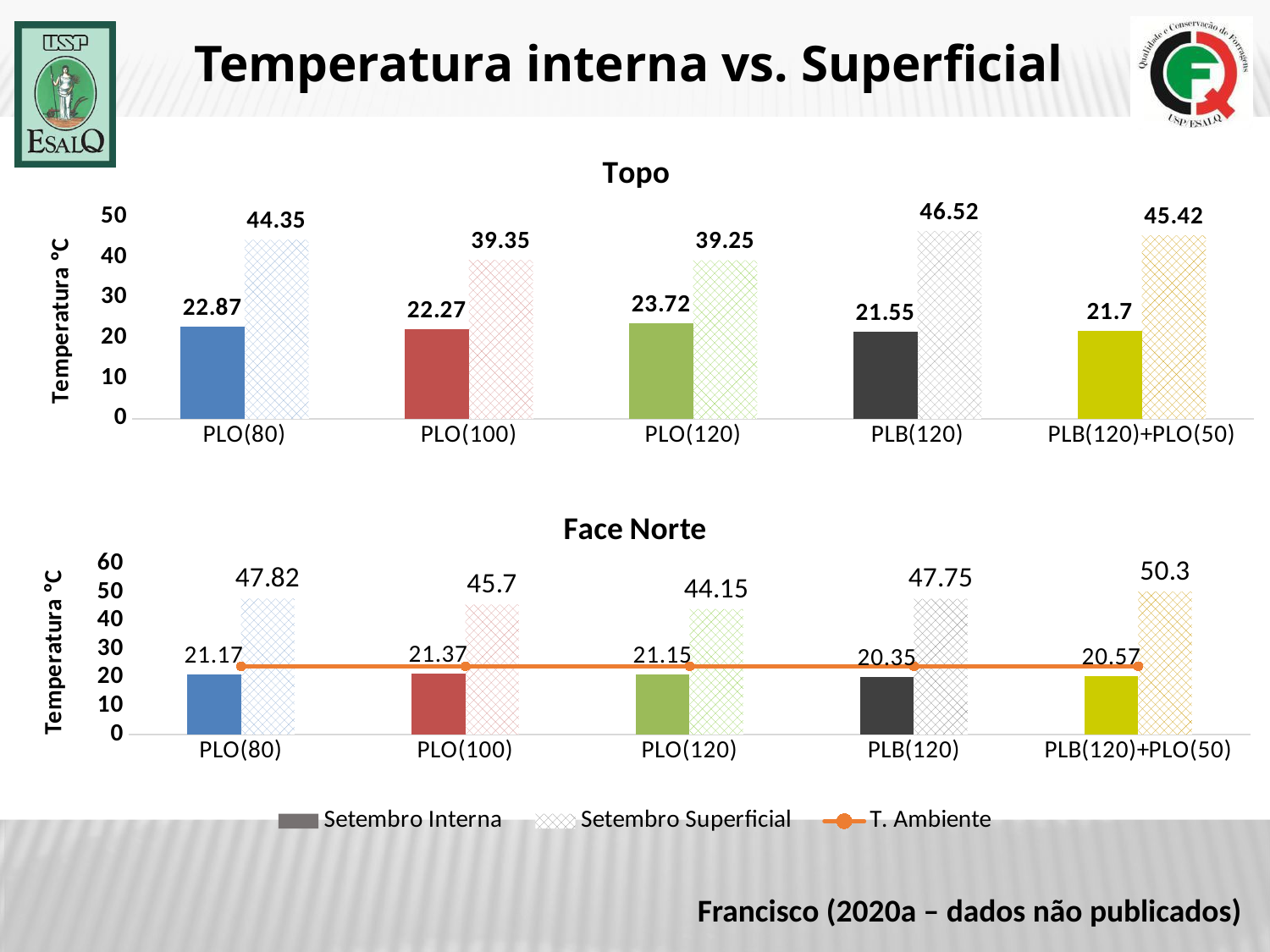
In the Topo chart, which category has the highest Setembro Superficial value? PLB(120) In the Topo chart, what is the difference between the Setembro Superficial and Setembro Interna values for PLO(80)? 21.48 In the Topo chart, what is the Setembro Superficial value for PLB(120)? 46.52 In the Topo chart, which category has the lowest Setembro Interna value? PLB(120) How many series does the legend at the bottom of the slide list? 3 In the Face Norte chart, is the T. Ambiente line greater or less than 30? less How many categories are shown on the x axis of the Topo chart? 5 In the Face Norte chart, is the Setembro Superficial value for PLO(100) larger or smaller than that for PLB(120)? smaller In the Topo chart, what is the Setembro Interna value for PLO(120)? 23.72 In the Face Norte chart, what is the Setembro Superficial value for PLB(120)+PLO(50)? 50.3 In the Face Norte chart, which category has the lowest Setembro Superficial value? PLO(120) In the Face Norte chart, what is the Setembro Interna value for PLB(120)? 20.35